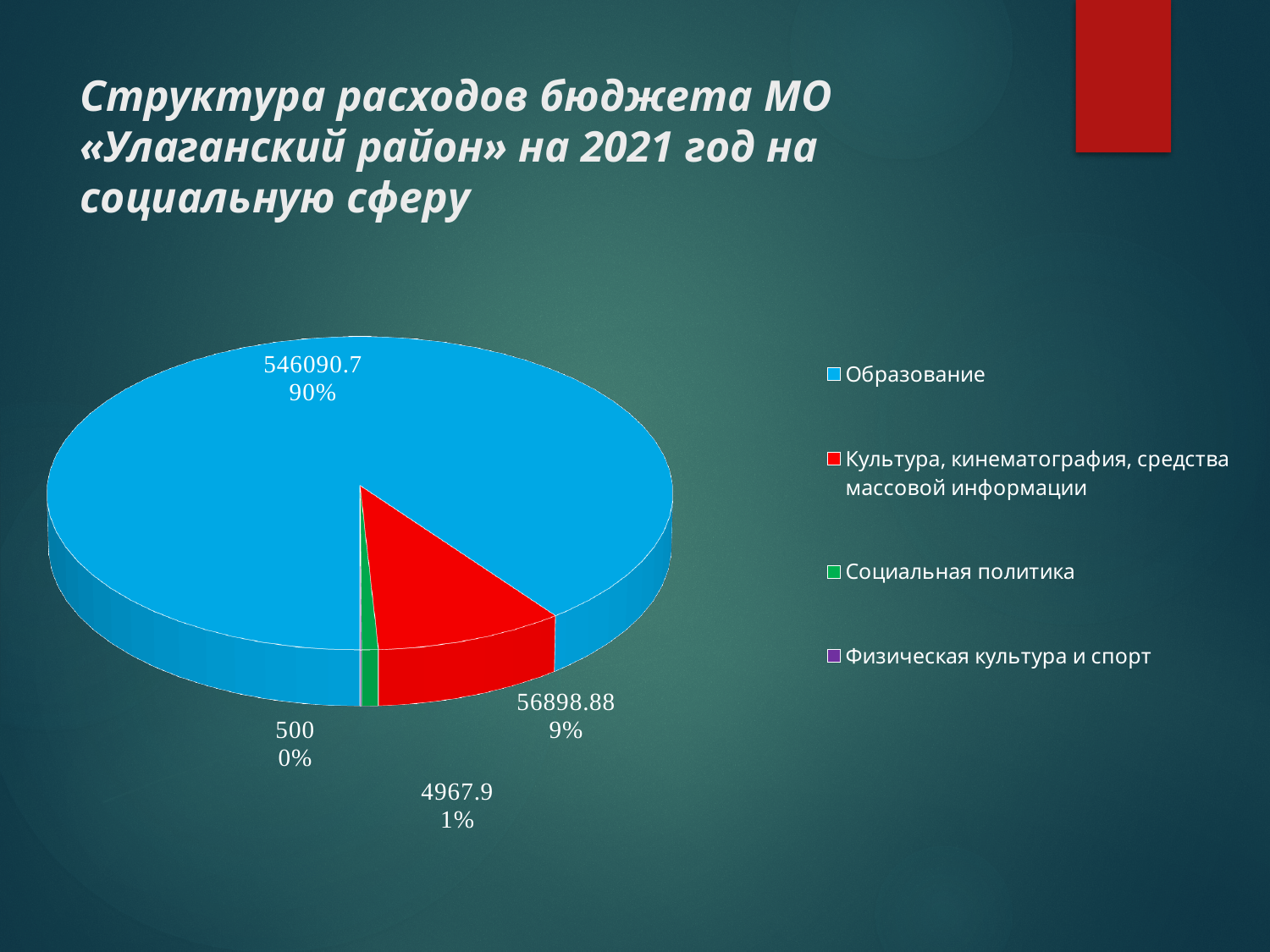
Which category has the largest slice? Образование How many entries does the legend list? 4 Which is larger, Образование or Культура, кинематография, средства массовой информации? Образование What share of the pie does Культура, кинематография, средства массовой информации take? 9% What share of the pie does Образование take? 90% What is the value for Образование? 546090.7 What is the value for Культура, кинематография, средства массовой информации? 56898.88 What kind of chart is shown on the slide? pie chart Which category has the smallest slice? Физическая культура и спорт What is the difference between the values for Образование and Культура, кинематография, средства массовой информации? 489191.82 How many slices does the pie chart have? 4 What share of the pie does Социальная политика take? 1%